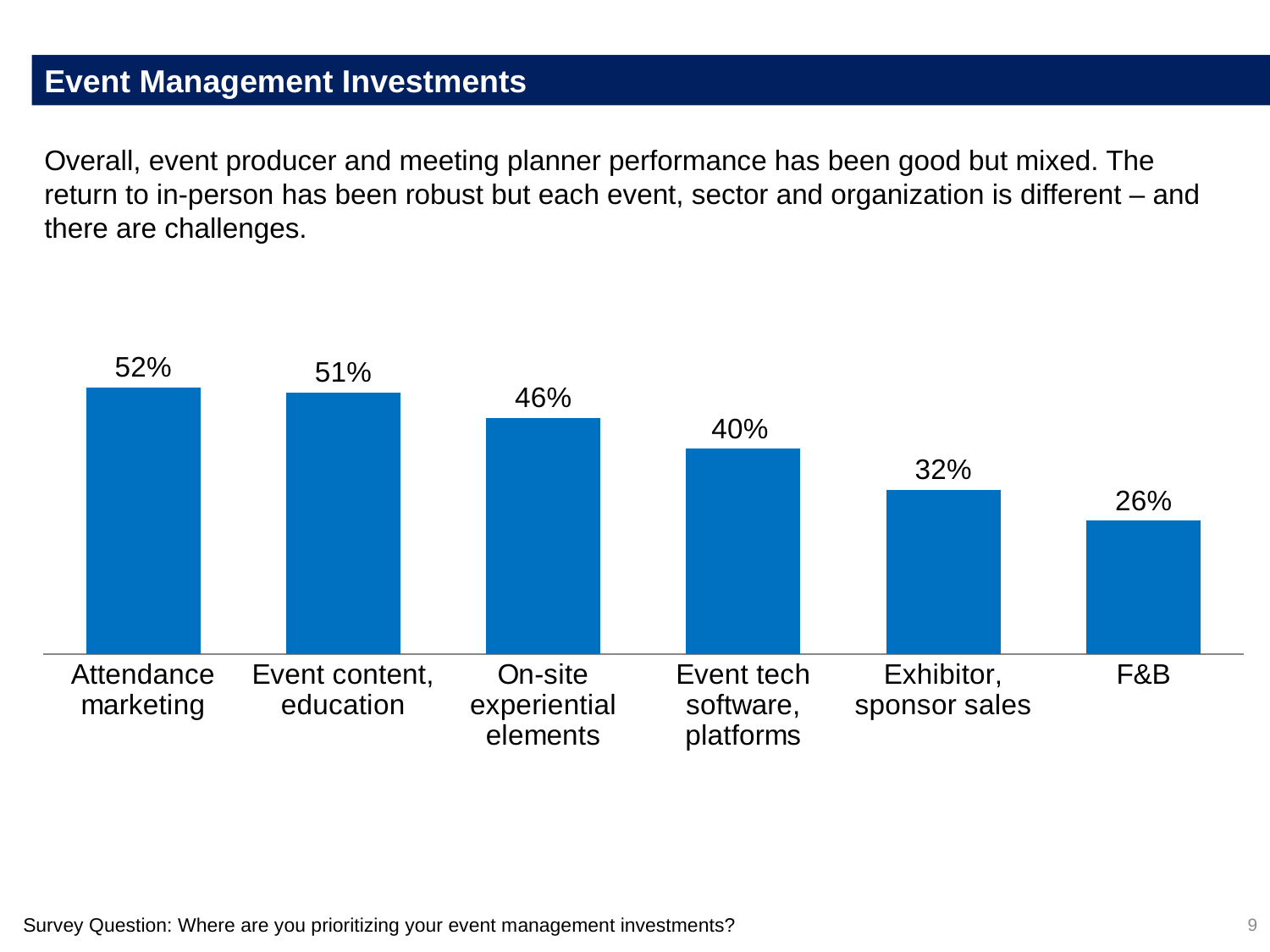
What is the difference between On-site experiential elements and Event tech software, platforms? 6% What is the value for Event tech software, platforms? 40% What percentage is shown for Exhibitor, sponsor sales? 32% Which is larger, Event content, education or Exhibitor, sponsor sales? Event content, education What is the title of the slide containing the chart? Event Management Investments Do the values rise or fall from left to right across the categories? Fall Which category has the lowest value? F&B What percentage is shown for Attendance marketing? 52% What is the difference between Attendance marketing and F&B? 26% Which category has the highest value? Attendance marketing How many categories are shown in the chart? 6 What kind of chart is shown on the slide? Bar chart